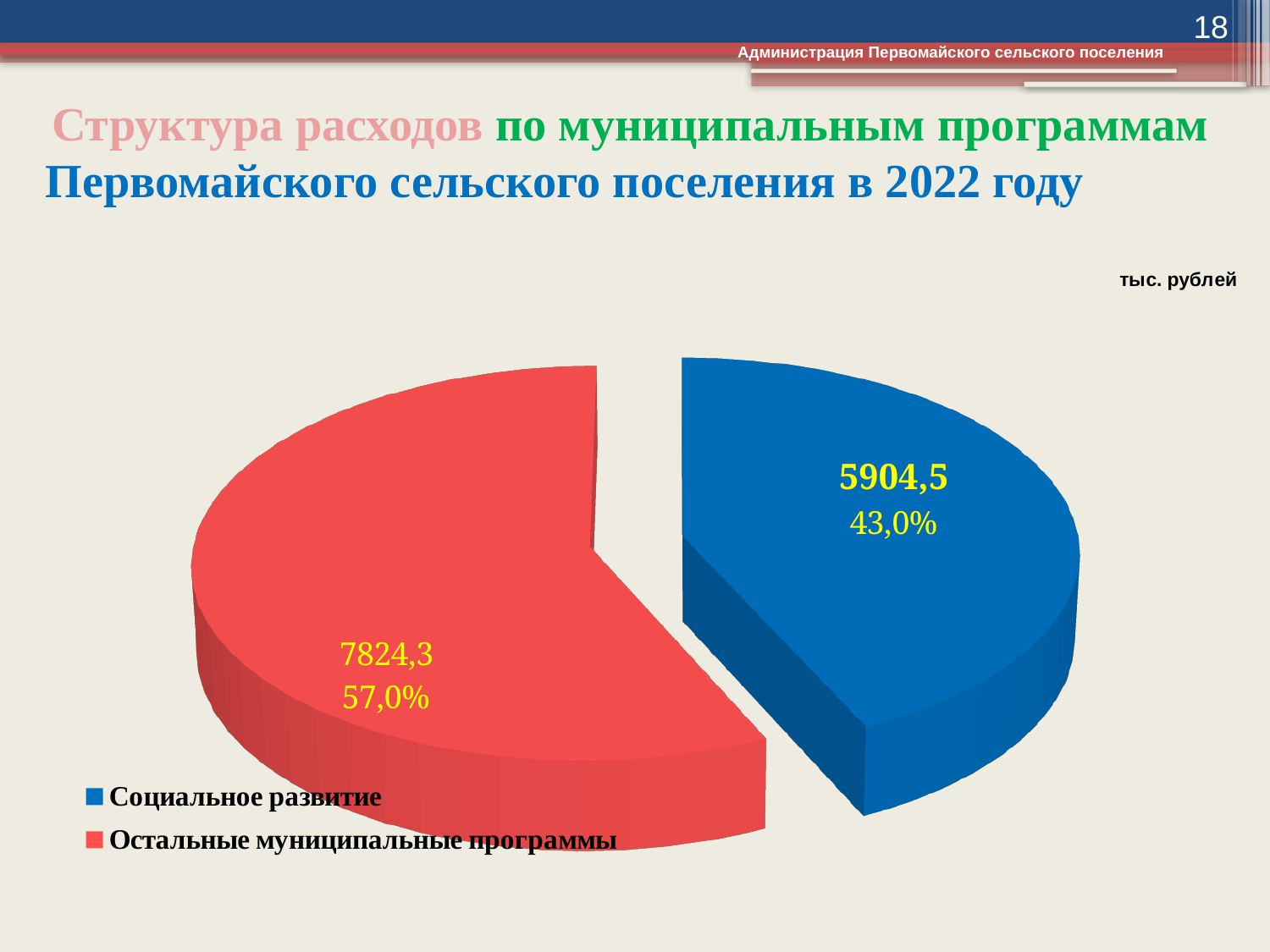
Which is larger: Социальное развитие or Остальные муниципальные программы? Остальные муниципальные программы Which category has the smallest slice of the pie? Социальное развитие What unit is stated for the values in the chart? тыс. рублей What kind of chart is shown on the slide? pie chart How many slices does the pie chart have? 2 What is the difference between the values for Остальные муниципальные программы and Социальное развитие? 1919,8 What is the value for Социальное развитие? 5904,5 Which category has the largest slice of the pie? Остальные муниципальные программы What share of the pie does Остальные муниципальные программы take? 57,0% What share of the pie does Социальное развитие take? 43,0% What is the value for Остальные муниципальные программы? 7824,3 What colour is the slice for Социальное развитие? blue